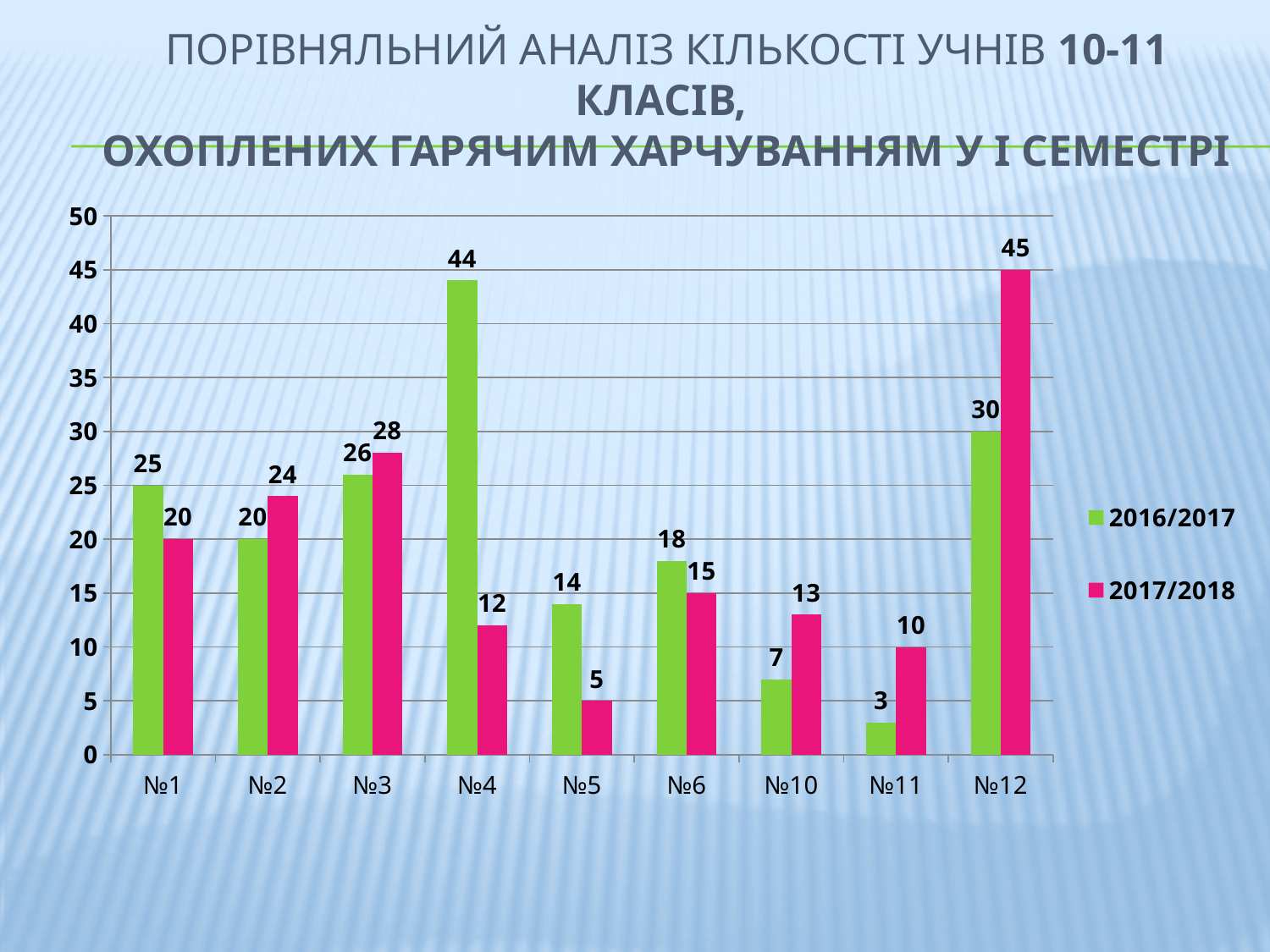
How many series does the legend list? 2 How many categories are shown on the x axis? 9 What is the value for №4 in the 2016/2017 series? 44 Which is larger for №3: the 2016/2017 value or the 2017/2018 value? 2017/2018 Is the value for №12 in the 2016/2017 series greater or less than 25? greater Which colour represents the 2017/2018 series? pink What kind of chart is shown on the slide? bar chart Which category has the lowest value in the 2016/2017 series? №11 What is the value for №12 in the 2017/2018 series? 45 What is the difference between the 2016/2017 and 2017/2018 values for №4? 32 Which category has the highest value in the 2017/2018 series? №12 What is the value for №11 in the 2016/2017 series? 3